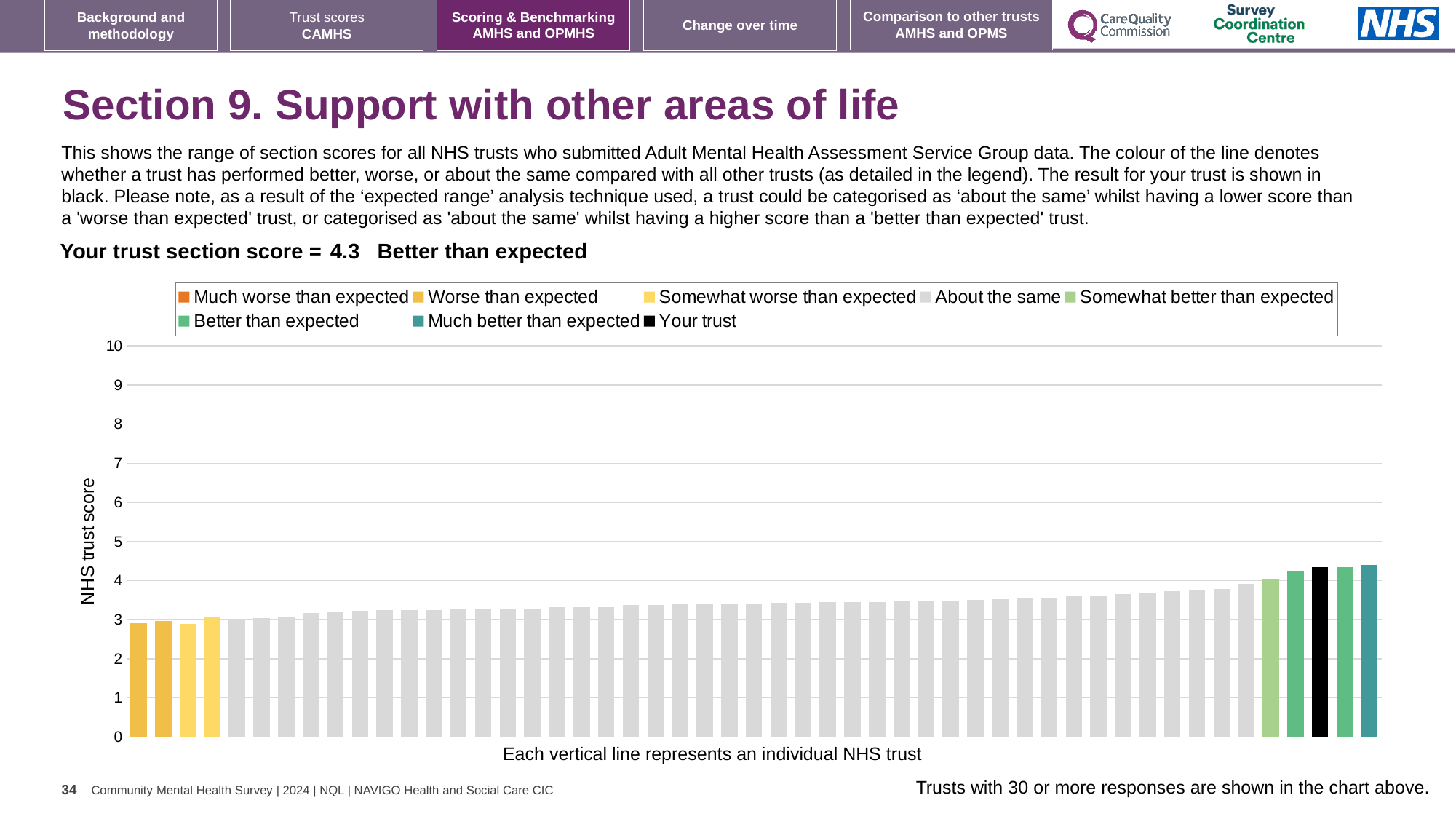
Do the bar values rise or fall from left to right along the x axis? rise How many entries does the chart legend list? 8 Is your trust's bar higher or lower than the grey 'About the same' bars? higher What is the label on the y axis of the chart? NHS trust score Is the value for your trust's bar greater or less than 4? greater Is the value of the tallest bar in the chart greater or less than 5? less What is the section score for your trust shown on the slide? 4.3 What colour is used for the 'Your trust' bar in the chart? black What kind of chart is shown on the slide? bar chart Is the value for your trust's bar greater or less than 5? less Is your trust's bar higher or lower than the tallest bar in the chart? lower